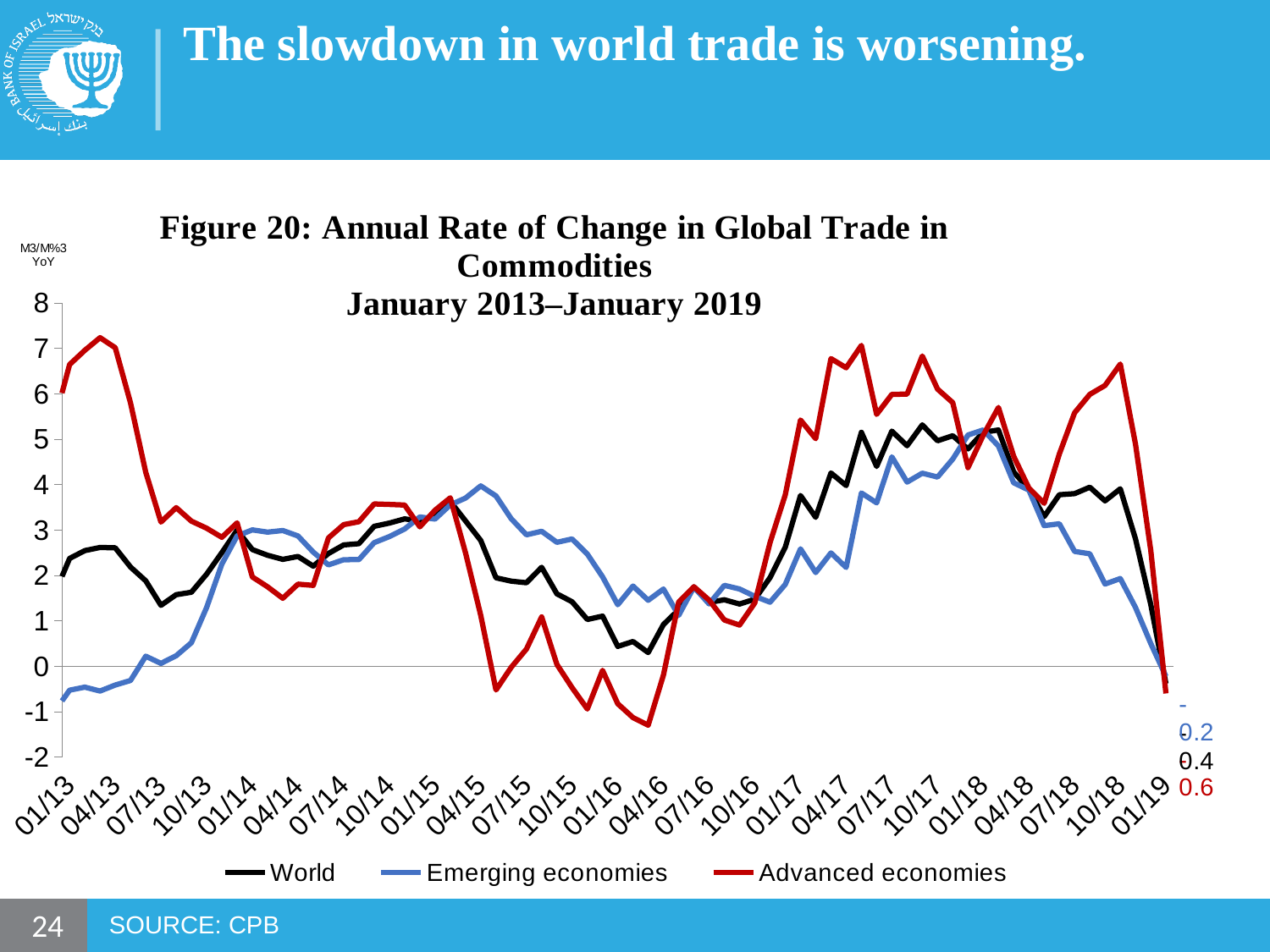
How many series does the legend list? 3 Is the value for Advanced economies at 04/13 greater or less than 6? greater What kind of chart is shown on the slide? line chart Is the value for World at 01/16 greater or less than 1? less At 04/13, which is larger: Advanced economies or Emerging economies? Advanced economies Is the value for Emerging economies at 01/13 greater or less than 0? less What are the three series listed in the legend? World, Emerging economies, Advanced economies Which series reaches the highest value anywhere on the chart? Advanced economies What colour is the line for Advanced economies? red At 04/15, which is larger: Emerging economies or Advanced economies? Emerging economies Do the values for Advanced economies rise or fall between 10/18 and 01/19? fall